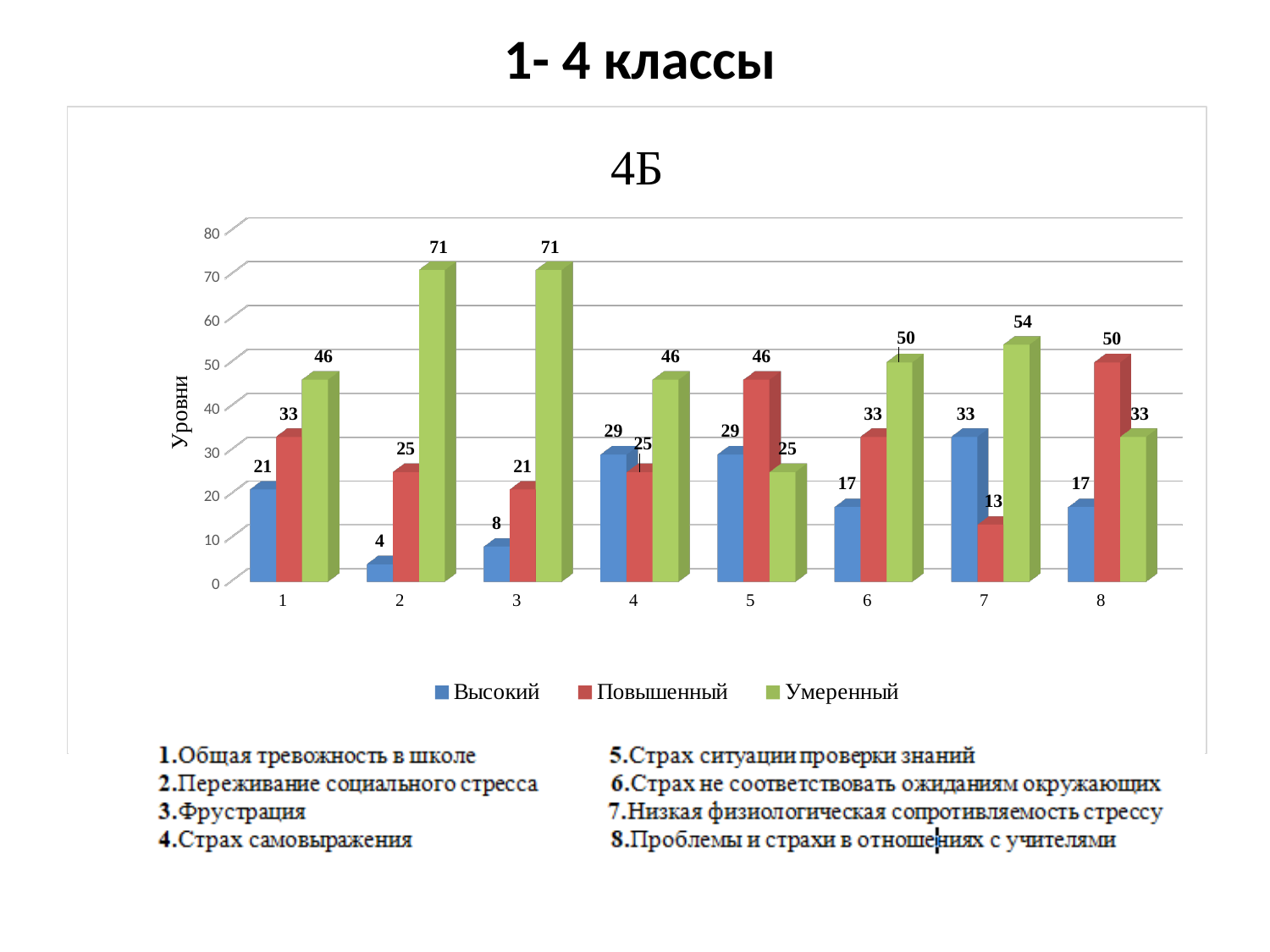
What is the label of the vertical axis? Уровни What is the value of the Повышенный series for category 8? 50 What is the title of the chart? 4Б What is the difference between the Умеренный and Высокий values for category 2? 67 What is the value of the Высокий series for category 2? 4 How many series does the legend list? 3 What is the value of the Умеренный series for category 7? 54 For category 5, which is larger: the Повышенный value or the Умеренный value? Повышенный Which category has the lowest value in the Повышенный series? 7 How many categories are shown on the x axis? 8 What kind of chart is shown on the slide? bar chart Which category has the highest value in the Высокий series? 7